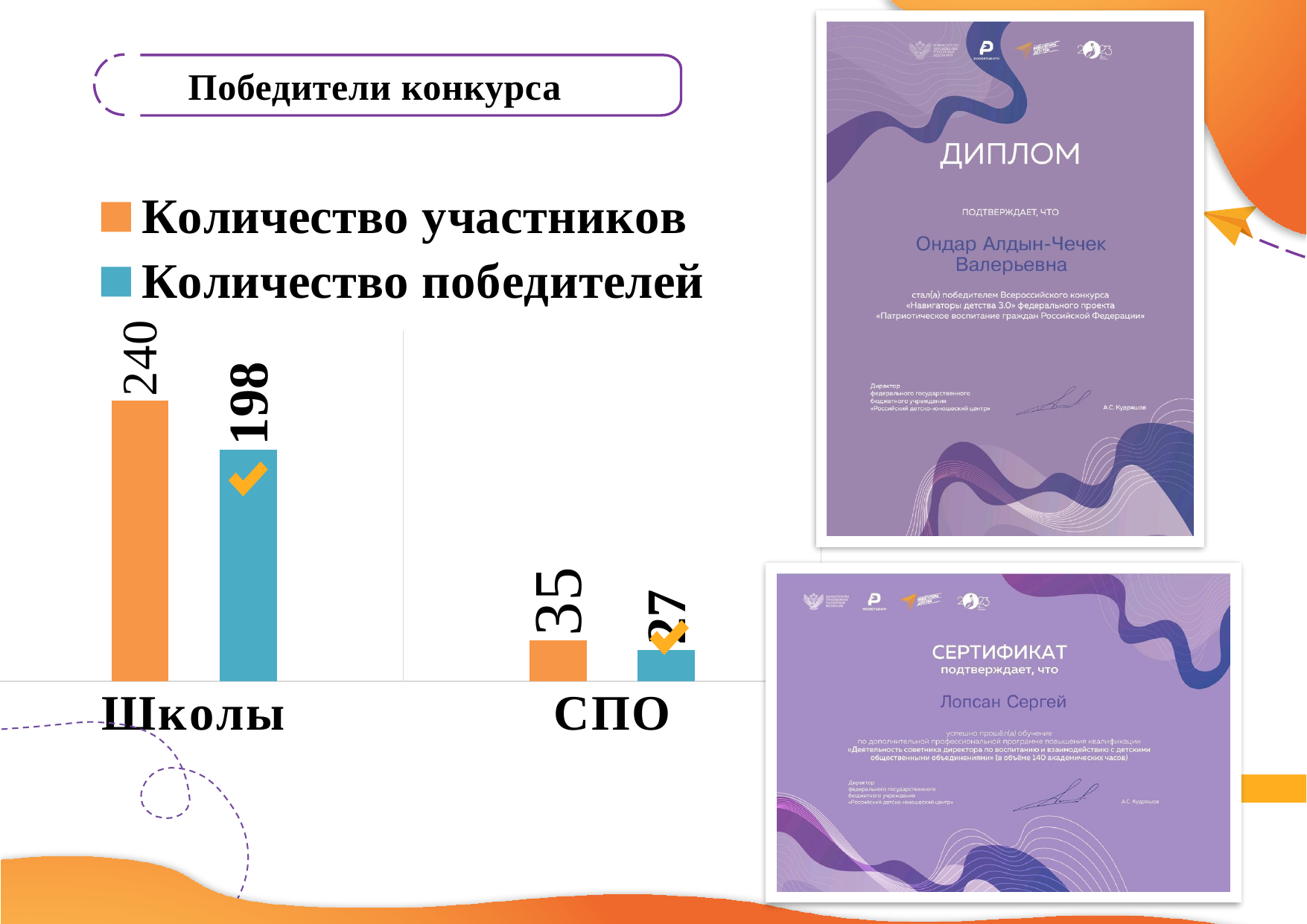
Which is larger for Школы: Количество участников or Количество победителей? Количество участников How many series does the chart legend list? 2 How many categories are shown on the x axis of the chart? 2 What is the value of Количество участников for СПО? 35 What is the difference in Количество участников between Школы and СПО? 205 What is the difference between Количество участников and Количество победителей for Школы? 42 Which category has the lowest value for Количество победителей? СПО Which category has the highest value for Количество участников? Школы What kind of chart is shown on the slide? bar chart What is the value of Количество победителей for Школы? 198 Which colour represents Количество победителей in the chart? blue What is the value of Количество участников for Школы? 240